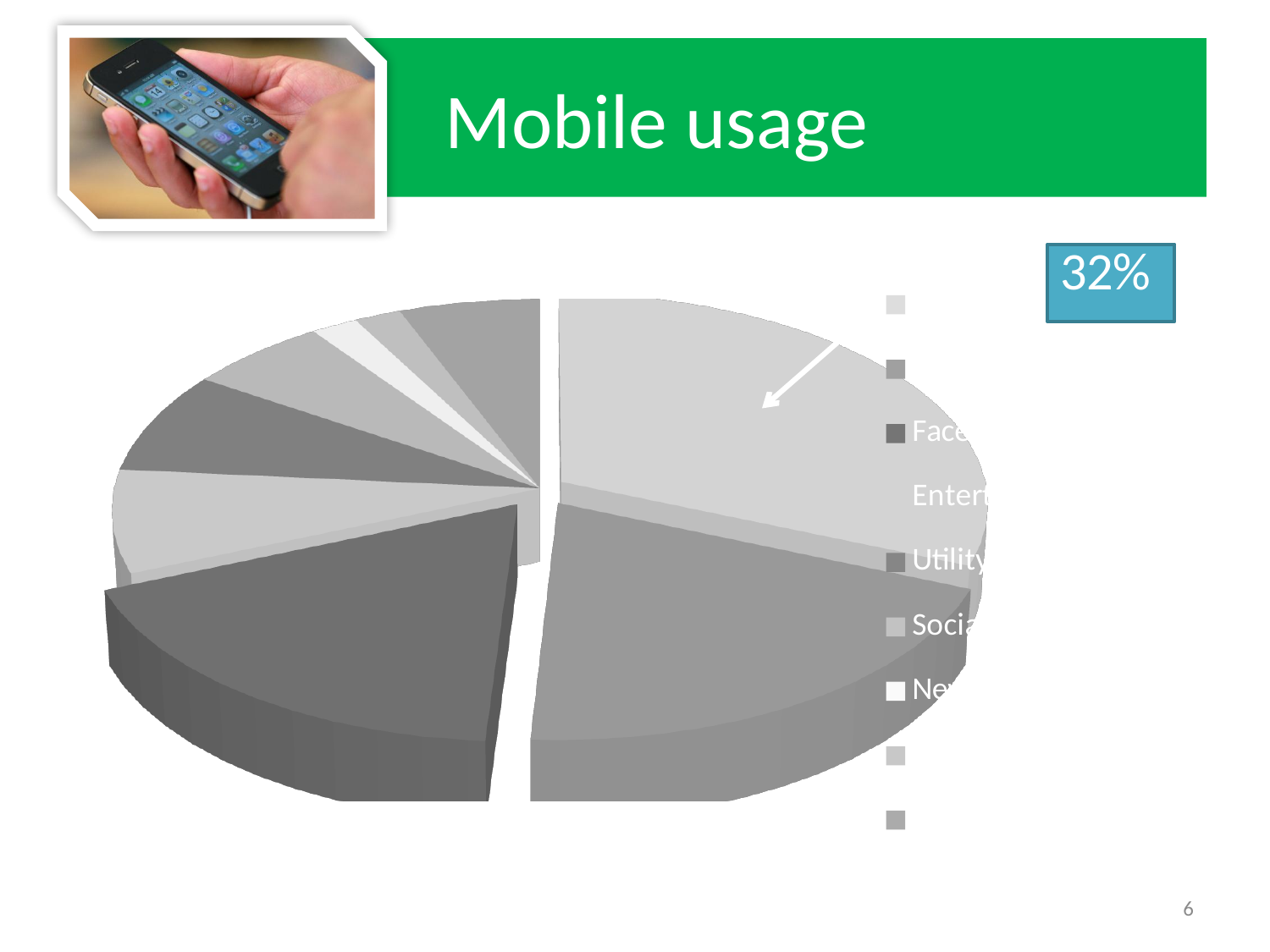
How many slices does the pie chart have? 9 Is the slice labelled with the 32% callout the largest slice of the pie chart? Yes What percentage is shown in the callout box pointing to the largest slice of the pie chart? 32% Which legend entry of the pie chart is fully readable and begins with 'Util'? Utility What is the title of the slide containing the pie chart? Mobile usage What kind of chart is shown on the slide? pie chart